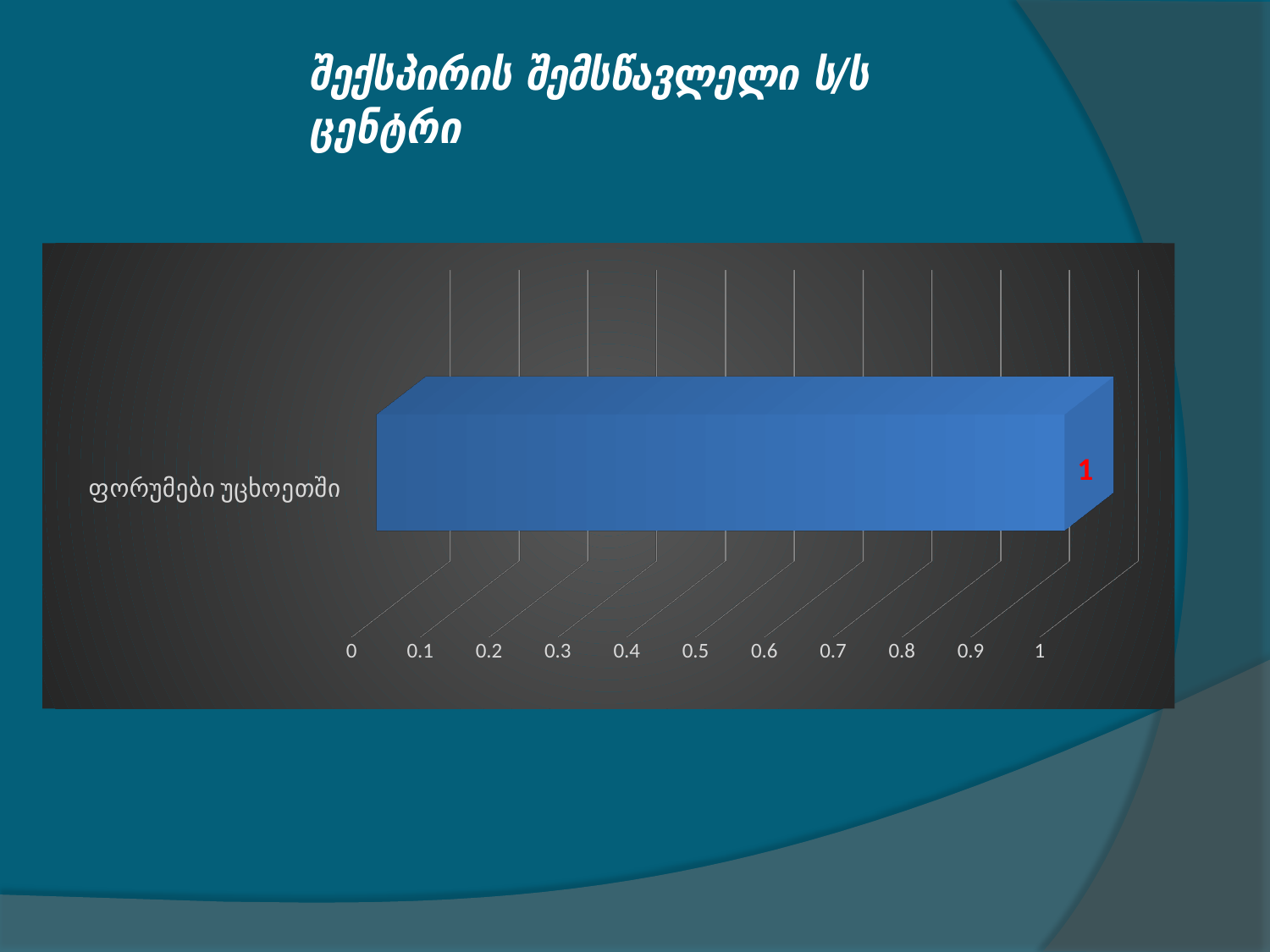
What is the highest tick value shown on the value axis of the chart? 1 What kind of chart is shown on the slide? bar chart Which category has the highest value in the chart? ფორუმები უცხოეთში Is the value for ფორუმები უცხოეთში greater or less than 0.5? greater How many categories are plotted in the chart? 1 Is the value for ფორუმები უცხოეთში greater or less than 0.9? greater What is the label of the only category shown in the chart? ფორუმები უცხოეთში What is the value for ფორუმები უცხოეთში? 1